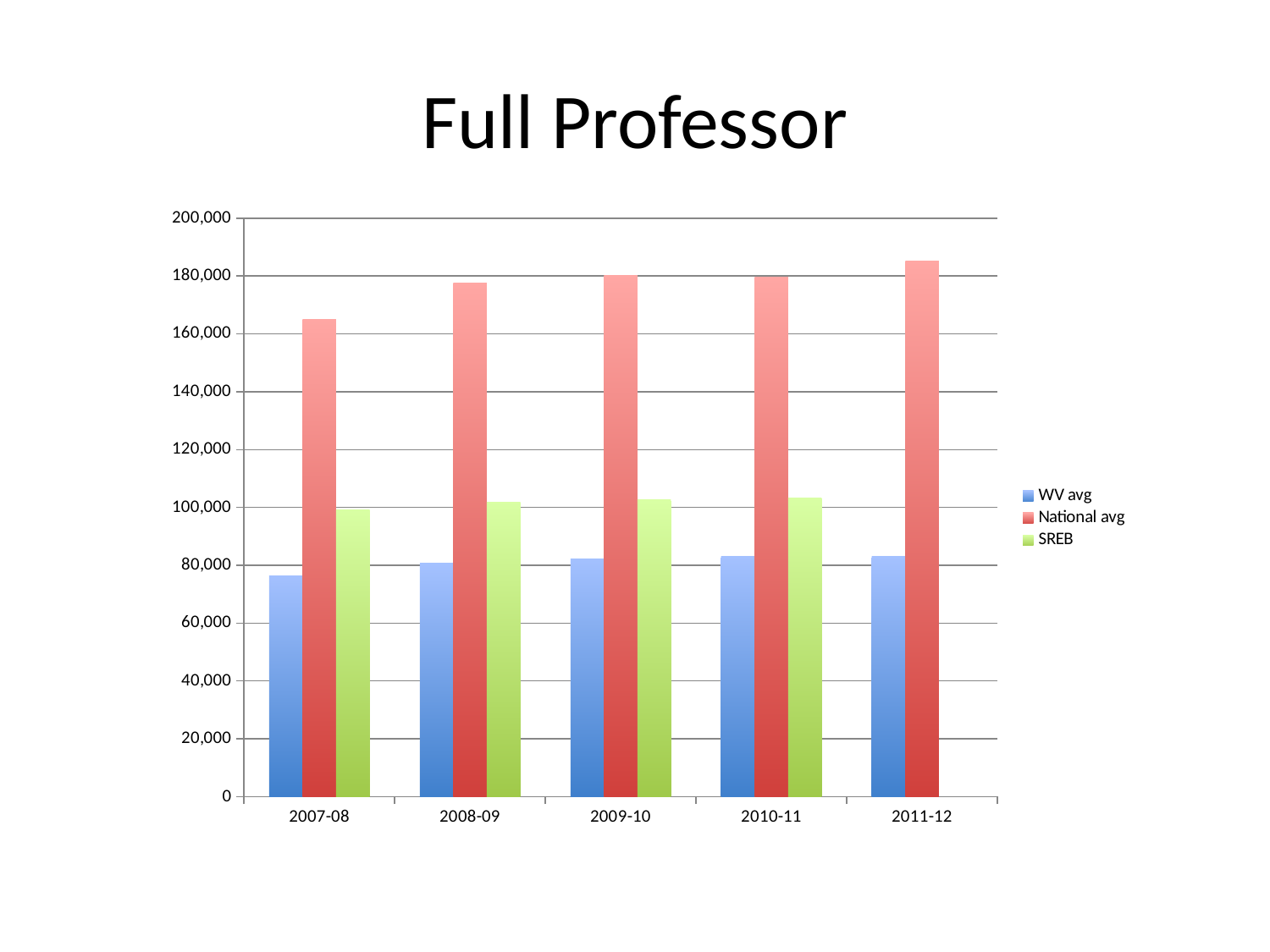
What is the title of the chart? Full Professor Is the SREB value for 2010-11 greater or less than 100,000? greater Is the WV avg value for 2007-08 greater or less than 80,000? less In which year is the National avg highest? 2011-12 How many academic years are shown on the x axis? 5 Is the National avg value for 2007-08 greater or less than 160,000? greater In 2007-08, which is larger, WV avg or SREB? SREB Which series is shown in red? National avg What kind of chart is shown on the slide? bar chart How many series does the legend list? 3 In which year is the WV avg lowest? 2007-08